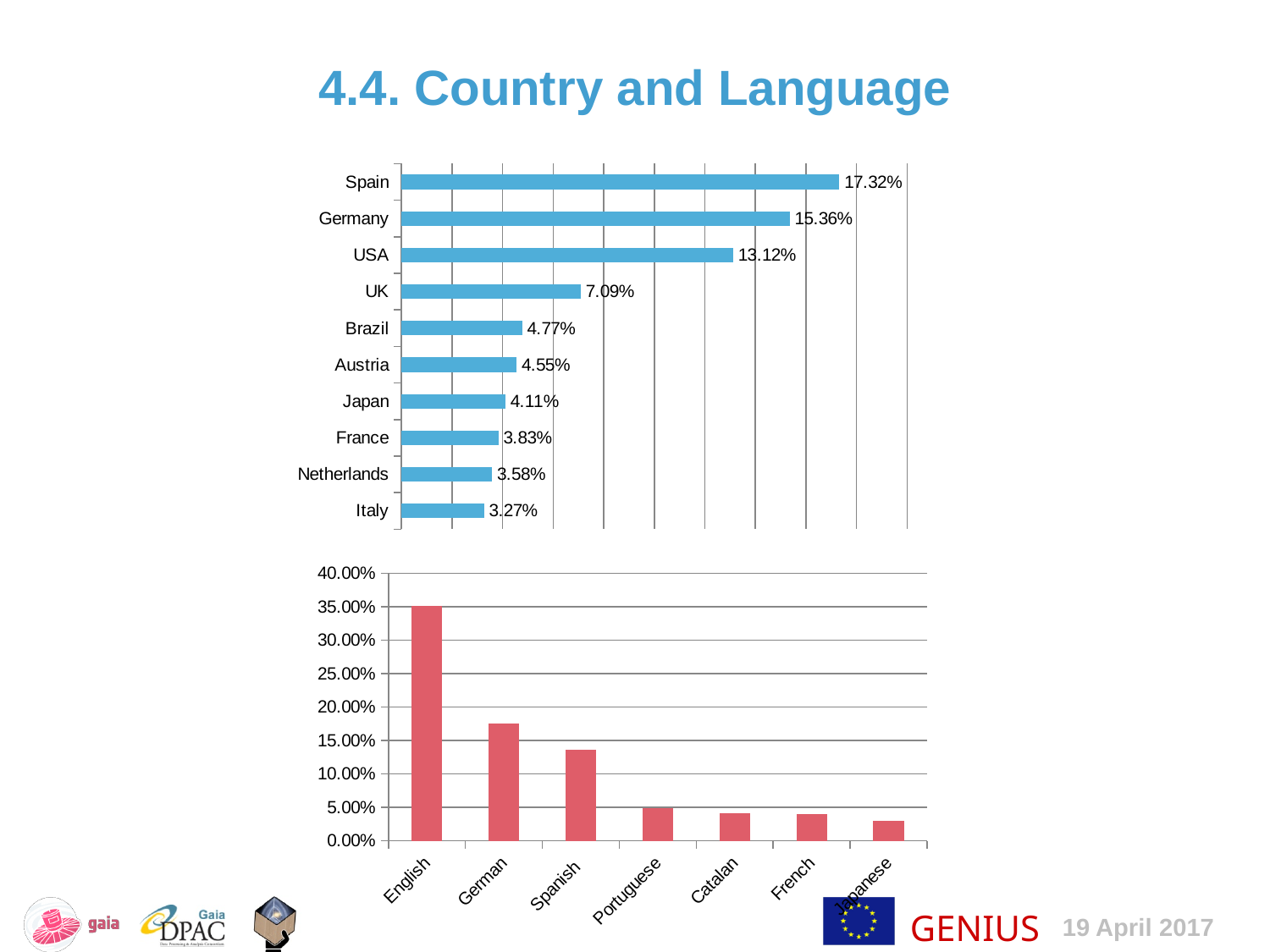
In the bottom chart (languages), how many languages are shown? 7 In the bottom chart (languages), is the value for English greater or less than 30.00%? greater In the bottom chart (languages), is the value for Spanish greater or less than 15.00%? less In the top chart (countries), which is larger, the value for UK or the value for Japan? UK In the top chart (countries), how many countries are shown? 10 In the top chart (countries), what is the value for Brazil? 4.77% In the top chart (countries), what is the value for Germany? 15.36% What kind of chart is the bottom chart (languages)? Bar chart In the bottom chart (languages), which language has the highest value? English In the top chart (countries), which country has the highest value? Spain In the top chart (countries), what is the difference between the values for Spain and USA? 4.20% In the top chart (countries), which country has the lowest value? Italy